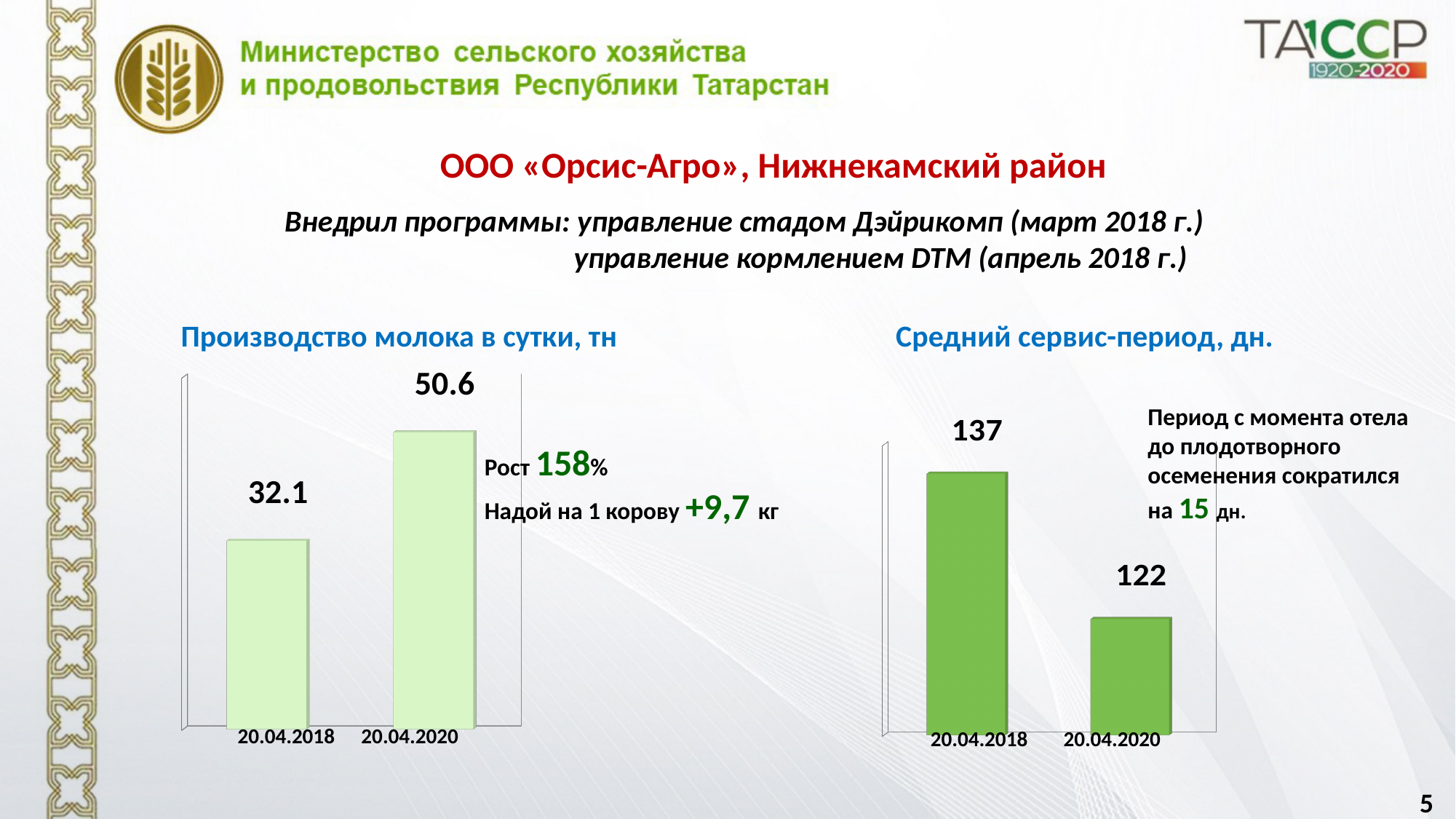
What type of chart is the one titled "Средний сервис-период, дн."? bar chart In the chart titled "Производство молока в сутки, тн", what is the value for 20.04.2018? 32.1 How many bars are shown in the chart titled "Производство молока в сутки, тн"? 2 In the chart titled "Производство молока в сутки, тн", what is the difference between the values for 20.04.2020 and 20.04.2018? 18.5 In the chart titled "Производство молока в сутки, тн", which date has the higher value? 20.04.2020 In the chart titled "Средний сервис-период, дн.", what is the value for 20.04.2020? 122 In the chart titled "Производство молока в сутки, тн", what is the value for 20.04.2020? 50.6 In the chart titled "Средний сервис-период, дн.", by how much did the value decrease from 20.04.2018 to 20.04.2020? 15 In the chart titled "Средний сервис-период, дн.", is the value for 20.04.2018 larger or smaller than the value for 20.04.2020? larger In the chart titled "Средний сервис-период, дн.", which date has the lowest value? 20.04.2020 In the chart titled "Средний сервис-период, дн.", do the values rise or fall from 20.04.2018 to 20.04.2020? fall In the chart titled "Средний сервис-период, дн.", what is the value for 20.04.2018? 137